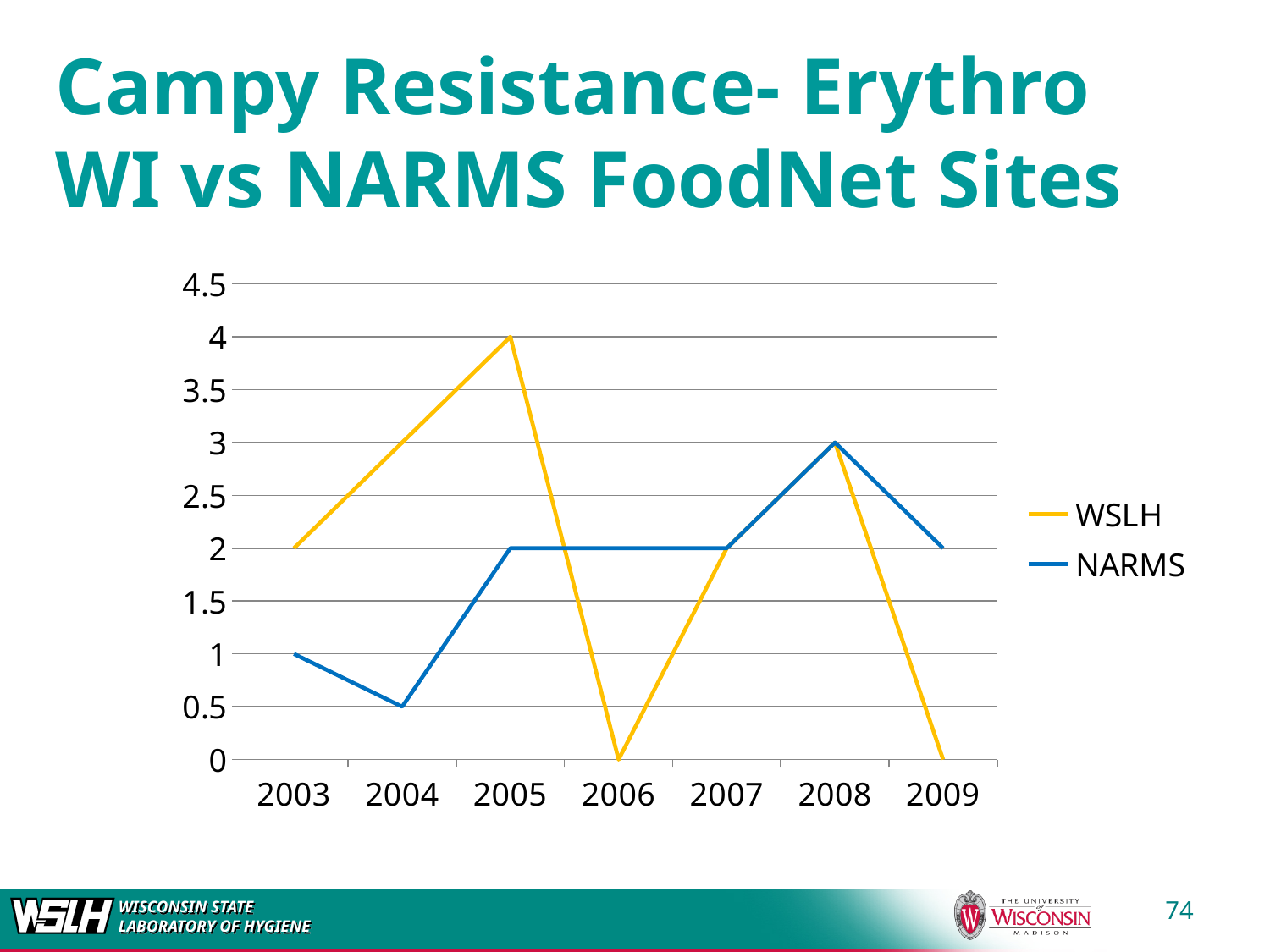
In which year does the WSLH series reach its highest value? 2005 Which series has the larger value in 2006, WSLH or NARMS? NARMS How many series does the legend list? 2 In which year does the NARMS series have its lowest value? 2004 Which series is drawn in blue? NARMS What is the WSLH value in 2006? 0 What is the NARMS value in 2009? 2 What kind of chart is shown on the slide? line chart What is the WSLH value in 2005? 4 What is the difference between the WSLH and NARMS values in 2003? 1 What is the NARMS value in 2004? 0.5 How many years are shown on the x axis? 7